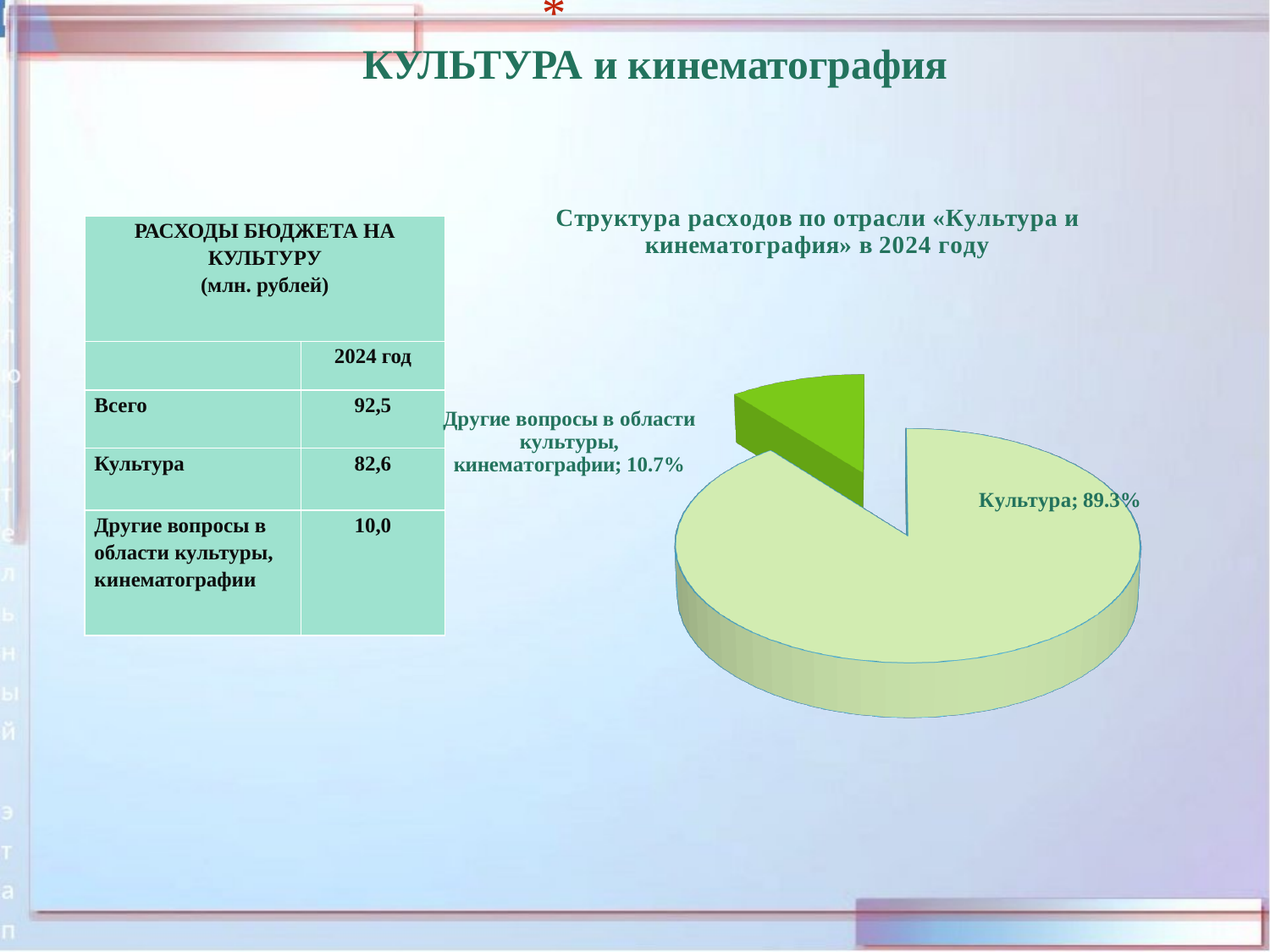
Which slice of the pie chart is the largest? Культура Which is larger in the pie chart: «Культура» or «Другие вопросы в области культуры, кинематографии»? Культура What kind of chart is shown on the slide? pie chart What share of the pie does the slice «Культура» represent? 89.3% What is the title of the pie chart? Структура расходов по отрасли «Культура и кинематография» в 2024 году Which slice of the pie chart is the smallest? Другие вопросы в области культуры, кинематографии What share of the pie does the slice «Другие вопросы в области культуры, кинематографии» represent? 10.7% Is the share of the «Другие вопросы в области культуры, кинематографии» slice greater or less than 20%? less How many slices does the pie chart have? 2 What colour is the «Культура» slice in the pie chart? light yellow-green By how many percentage points does the «Культура» slice exceed the «Другие вопросы в области культуры, кинематографии» slice? 78.6 Is the share of the «Культура» slice greater or less than 50%? greater